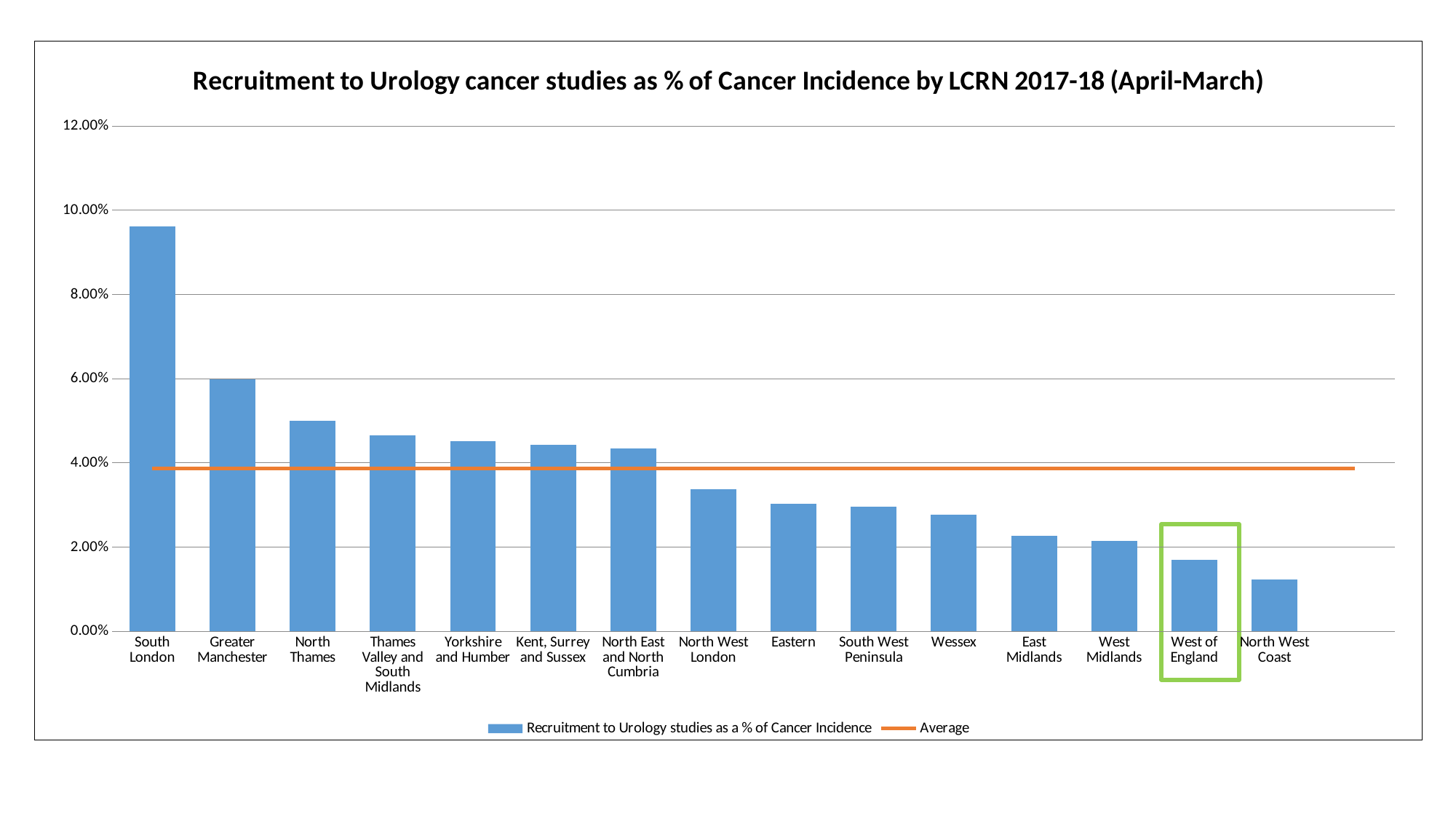
Is the value for West of England greater or less than 2.00%? less Which LCRN has the highest recruitment to Urology studies as a % of cancer incidence? South London Do the bar values rise or fall from left to right along the x axis? Fall Which has the larger value, Wessex or East Midlands? Wessex How many series does the legend list? 2 Is the value for South London greater or less than 8.00%? greater What kind of chart is shown on the slide? Bar chart Which LCRN has the lowest recruitment to Urology studies as a % of cancer incidence? North West Coast Which LCRN's bar is highlighted with a green box on the chart? West of England Is the value for North West Coast greater or less than 2.00%? less How many LCRNs are shown on the x axis of the chart? 15